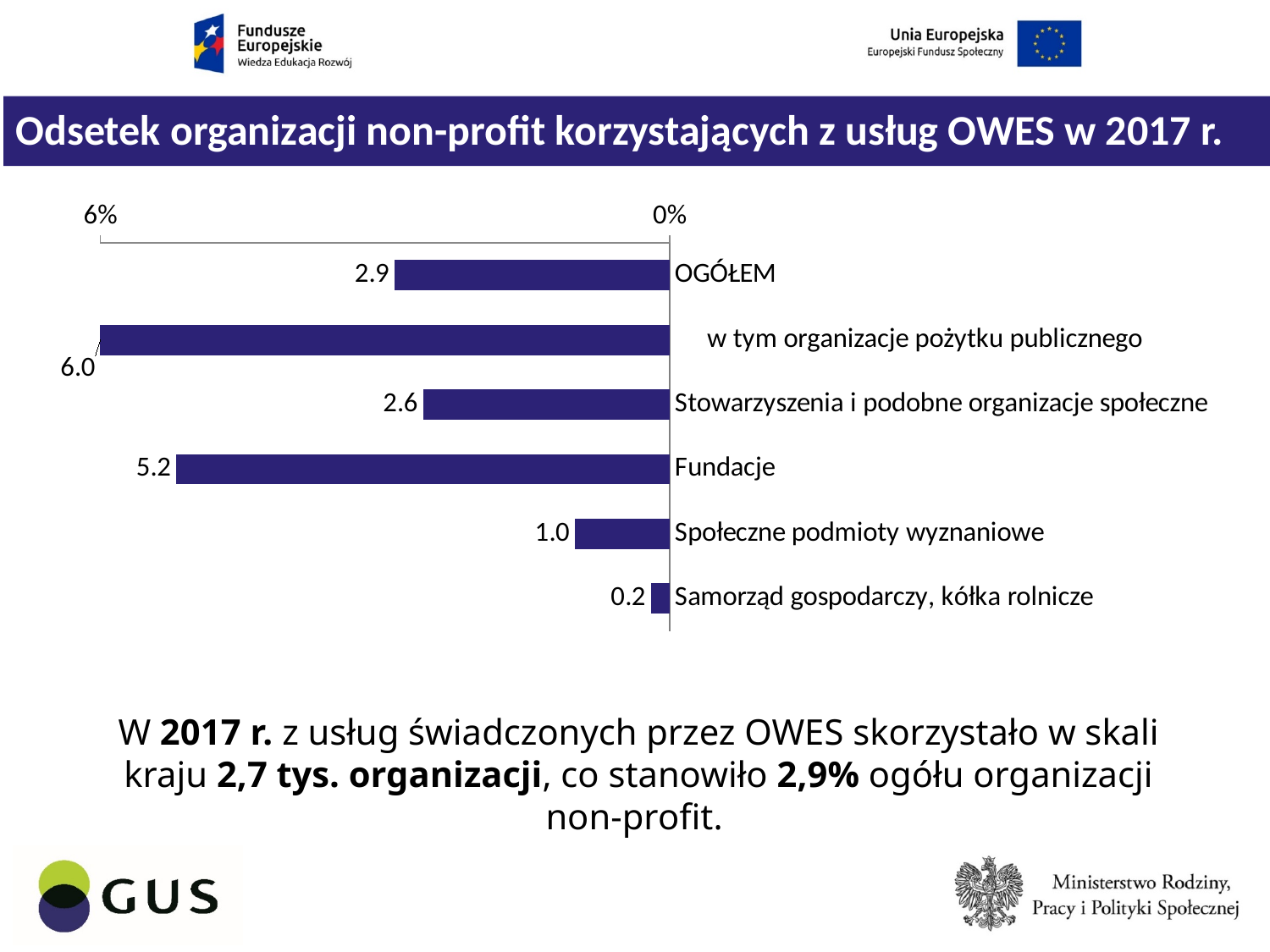
What is the value shown for Samorząd gospodarczy, kółka rolnicze? 0.2 What is the value shown for Fundacje? 5.2 What is the difference between the values for Fundacje and Stowarzyszenia i podobne organizacje społeczne? 2.6 Which category has the lowest value? Samorząd gospodarczy, kółka rolnicze How many categories are shown in the chart? 6 What kind of chart is shown on the slide? bar chart What is the difference between the values for w tym organizacje pożytku publicznego and Społeczne podmioty wyznaniowe? 5.0 Which is larger, the value for Fundacje or the value for OGÓŁEM? Fundacje What is the value shown for OGÓŁEM? 2.9 What is the title of the chart? Odsetek organizacji non-profit korzystających z usług OWES w 2017 r. Which category has the highest value? w tym organizacje pożytku publicznego What is the value shown for Społeczne podmioty wyznaniowe? 1.0